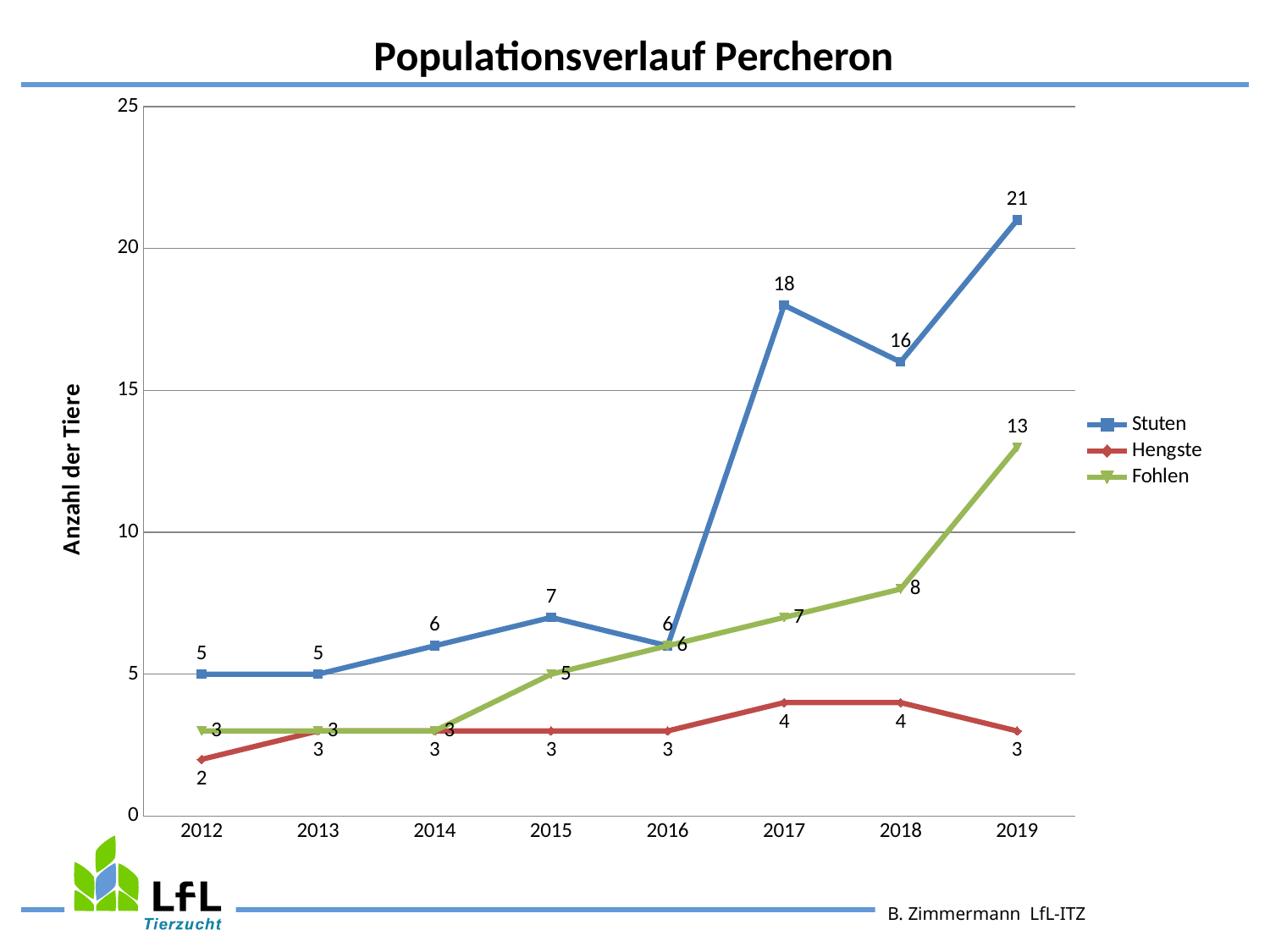
Which is larger in 2019, the value for Fohlen or the value for Hengste? Fohlen What is the value for Hengste in 2012? 2 What is the value for Stuten in 2019? 21 What is the value for Fohlen in 2018? 8 How many series does the legend list? 3 How many years are shown on the x axis? 8 Does the value for Fohlen rise or fall from 2014 to 2019? rise In which year is the value for Hengste lowest? 2012 What is the difference between the Stuten value in 2017 and the Stuten value in 2016? 12 What type of chart is shown on the slide? line chart What is the title of the chart? Populationsverlauf Percheron In which year is the value for Stuten highest? 2019